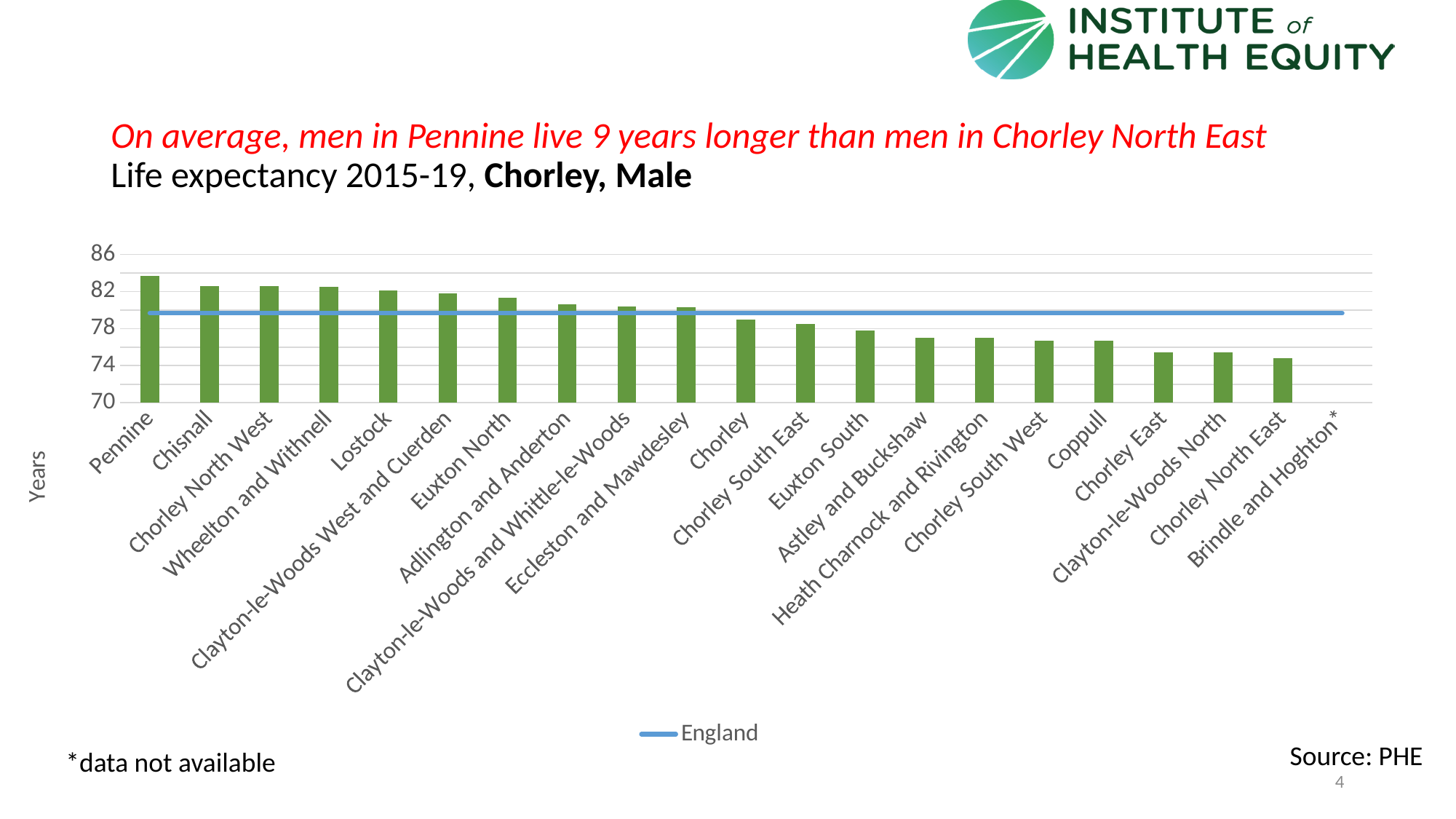
What kind of chart is shown on the slide? Bar chart Is the value for Chisnall greater or less than 78? greater Among the wards with data, which has the lowest male life expectancy? Chorley North East Is the value for Coppull greater or less than 78? less Which ward has the highest male life expectancy in the chart? Pennine Is the value for Pennine greater or less than 82? greater Which ward is marked with an asterisk as having no data available? Brindle and Hoghton Do the bar values rise or fall moving from left to right along the x axis? Fall What does the horizontal line in the chart represent, according to the legend? England Which is larger, the value for Lostock or the value for Chorley East? Lostock How many wards are labelled on the x axis of the chart? 21